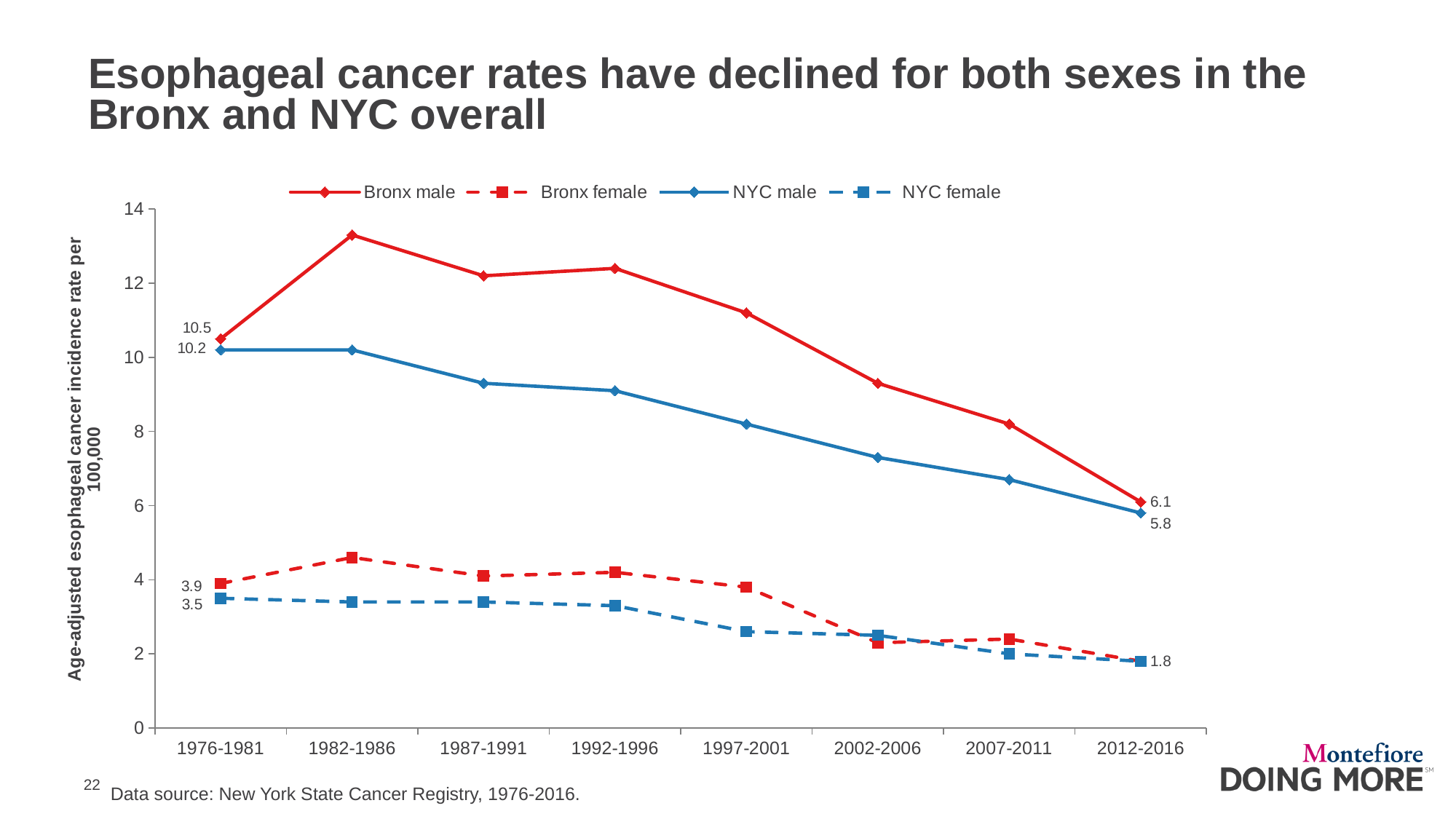
What is the NYC male esophageal cancer incidence rate for 1976-1981? 10.2 Is the Bronx male value for 1982-1986 greater or less than 12? greater What is the Bronx male esophageal cancer incidence rate for 1976-1981? 10.5 What kind of chart is shown on the slide? line chart By how much did the Bronx male rate fall from 1976-1981 to 2012-2016? 4.4 What is the NYC male esophageal cancer incidence rate for 2012-2016? 5.8 What is the Bronx male esophageal cancer incidence rate for 2012-2016? 6.1 How many series does the legend list? 4 How many time periods are shown on the x axis? 8 What is the Bronx female esophageal cancer incidence rate for 1976-1981? 3.9 Does the NYC male rate rise or fall from 1982-1986 to 2012-2016? fall In which period is the Bronx male rate highest? 1982-1986